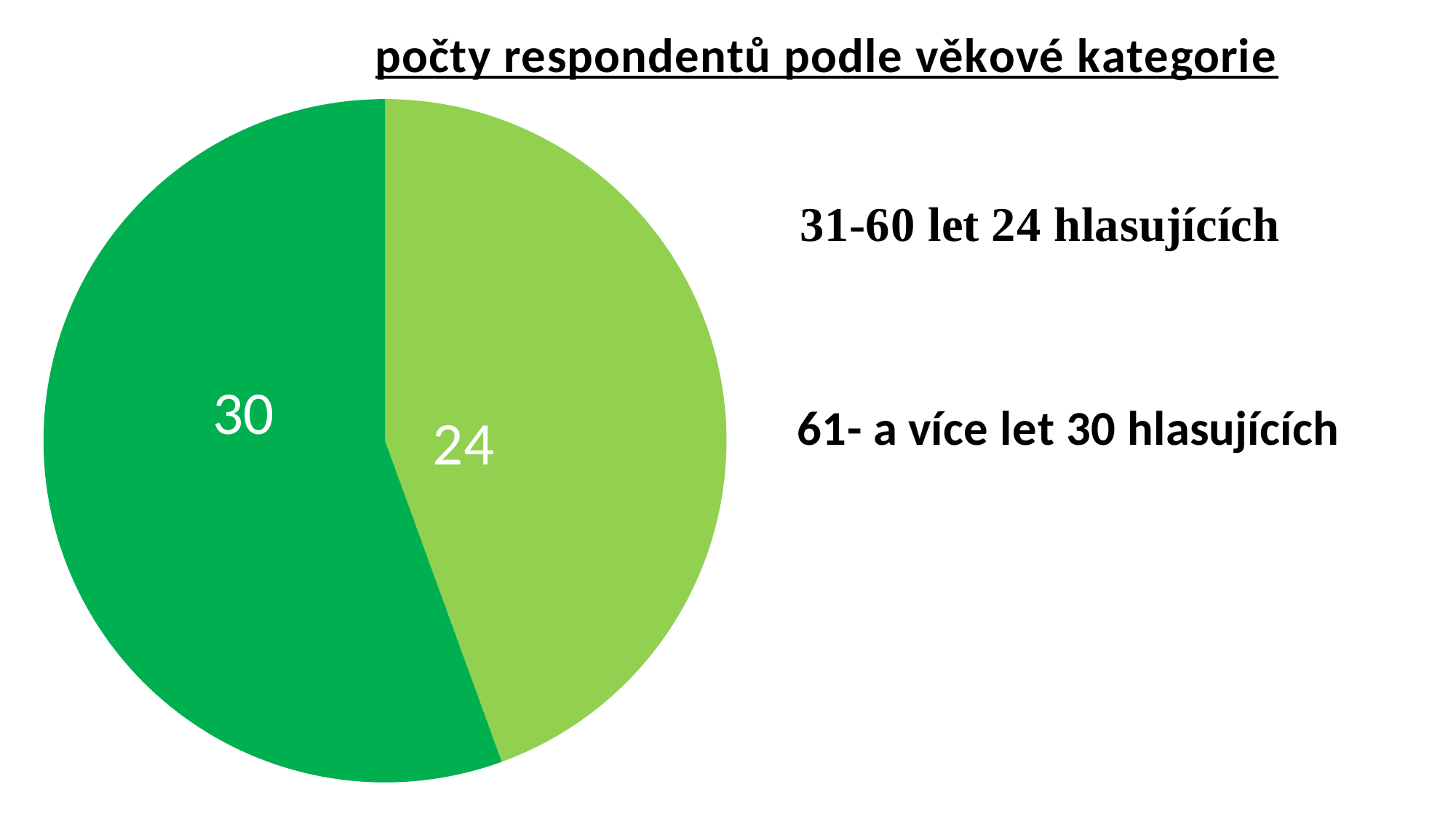
What is the title of the chart? počty respondentů podle věkové kategorie Which age category has the larger number of respondents? 61- a více let How many slices does the pie chart have? 2 What is the difference between the two slice values in the pie chart? 6 What is the value of the light green slice of the pie chart? 24 What is the total number of respondents across both slices of the pie chart? 54 What is the value of the dark green slice of the pie chart? 30 Which age category has the smaller number of respondents? 31-60 let How many respondents are in the 31-60 let age category? 24 Is the slice labelled 30 larger or smaller than the slice labelled 24? larger What kind of chart is shown on the slide? pie chart How many respondents are in the 61- a více let age category? 30